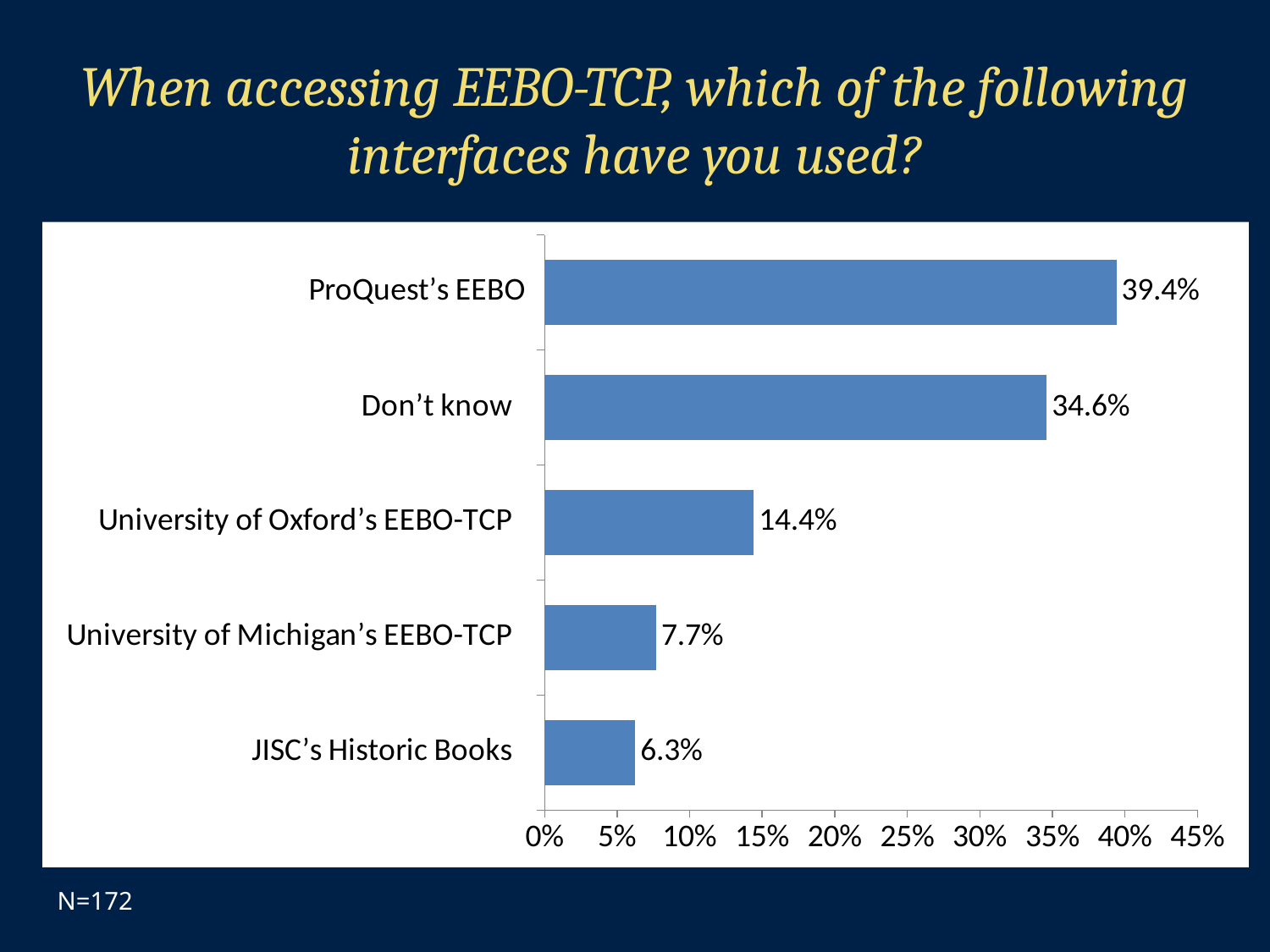
What is the difference between University of Oxford's EEBO-TCP and University of Michigan's EEBO-TCP? 6.7% What is the value for University of Oxford's EEBO-TCP? 14.4% How many categories are shown in the chart? 5 What is the sample size noted on the slide? N=172 Which interface has the highest percentage? ProQuest's EEBO What is the difference between ProQuest's EEBO and Don't know? 4.8% What percentage is shown for JISC's Historic Books? 6.3% What percentage of respondents have used ProQuest's EEBO? 39.4% Is the value for Don't know greater or less than 30%? greater Which is larger: University of Michigan's EEBO-TCP or JISC's Historic Books? University of Michigan's EEBO-TCP What kind of chart is shown on the slide? bar chart Which category has the lowest percentage? JISC's Historic Books